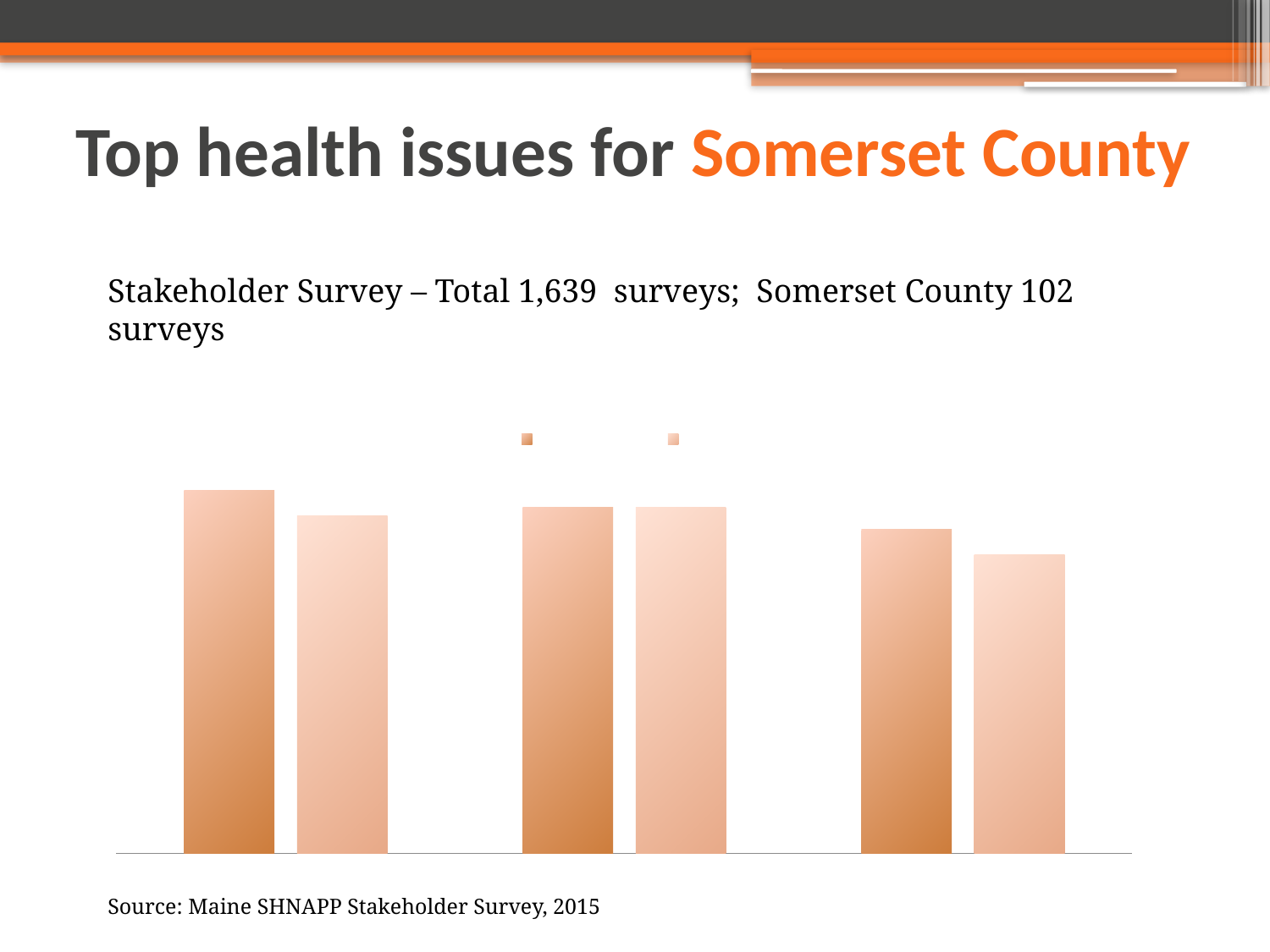
In the rightmost group of bars, is the darker bar or the lighter bar taller? the darker bar What kind of chart is shown on the slide? bar chart What colours are used for the two series of bars? two shades of orange (darker and lighter) Which group of bars contains the tallest bar on the chart? the leftmost group Do the darker bars rise or fall from left to right across the three groups? fall In the leftmost group of bars, is the darker bar or the lighter bar taller? the darker bar Which group of bars contains the shortest bar on the chart? the rightmost group How many groups of bars does the chart show? 3 How many series does the chart's legend list? 2 How many bars are plotted in total on the chart? 6